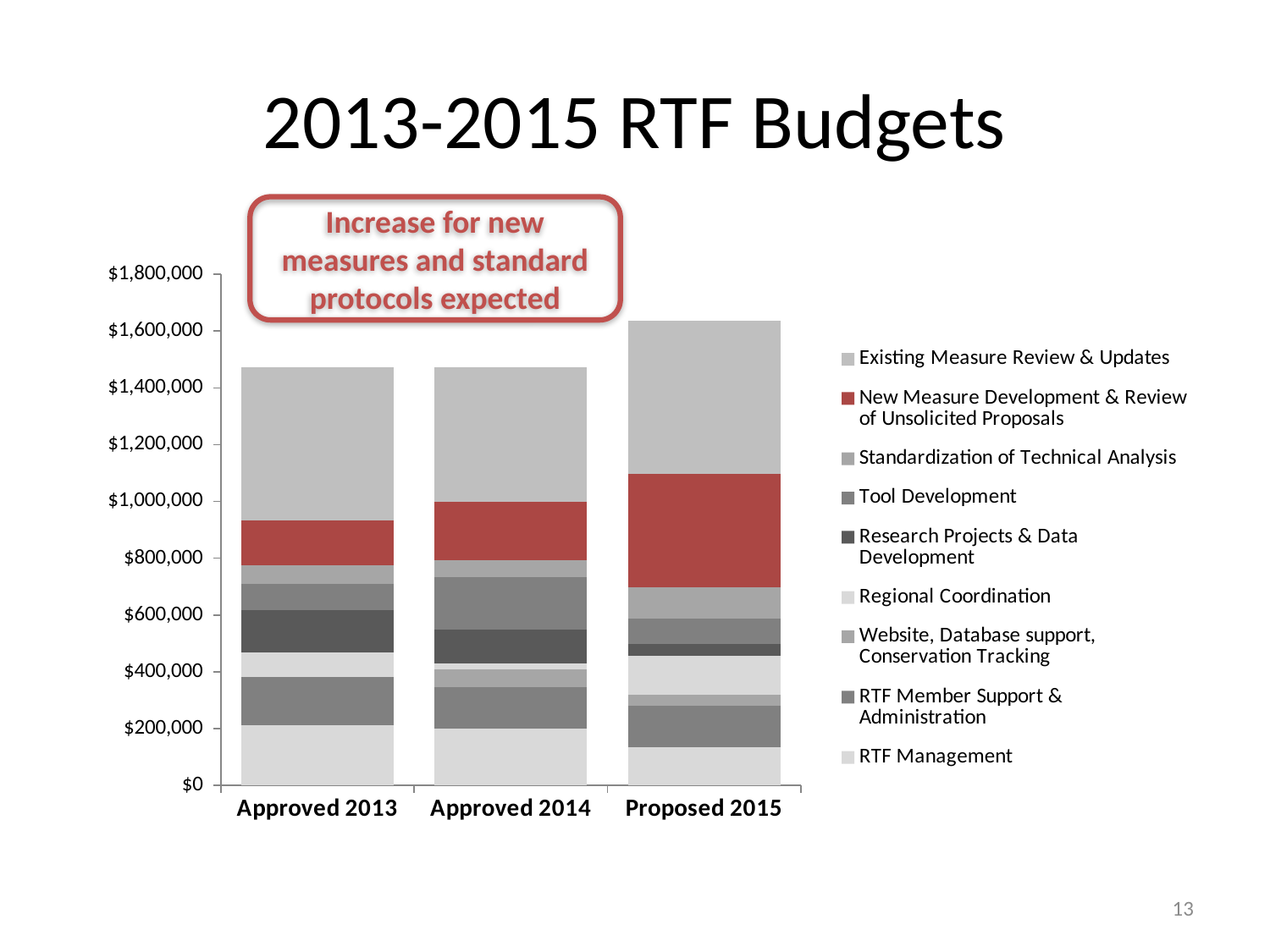
Is the total for Approved 2013 greater or less than $1,600,000? less Which legend series is shown in red? New Measure Development & Review of Unsolicited Proposals Which is larger, the total for Proposed 2015 or the total for Approved 2013? Proposed 2015 Which bar has the larger New Measure Development & Review of Unsolicited Proposals segment, Approved 2013 or Proposed 2015? Proposed 2015 How many series does the legend list? 9 What is the label of the bottom series in the legend? RTF Management Is the total for Proposed 2015 greater or less than $1,400,000? greater What kind of chart is shown on the slide? Stacked bar chart Is the total for Approved 2014 greater or less than $1,200,000? greater What is the title of the slide? 2013-2015 RTF Budgets How many budget years (bars) are shown on the x axis? 3 Which budget year has the tallest stacked bar? Proposed 2015